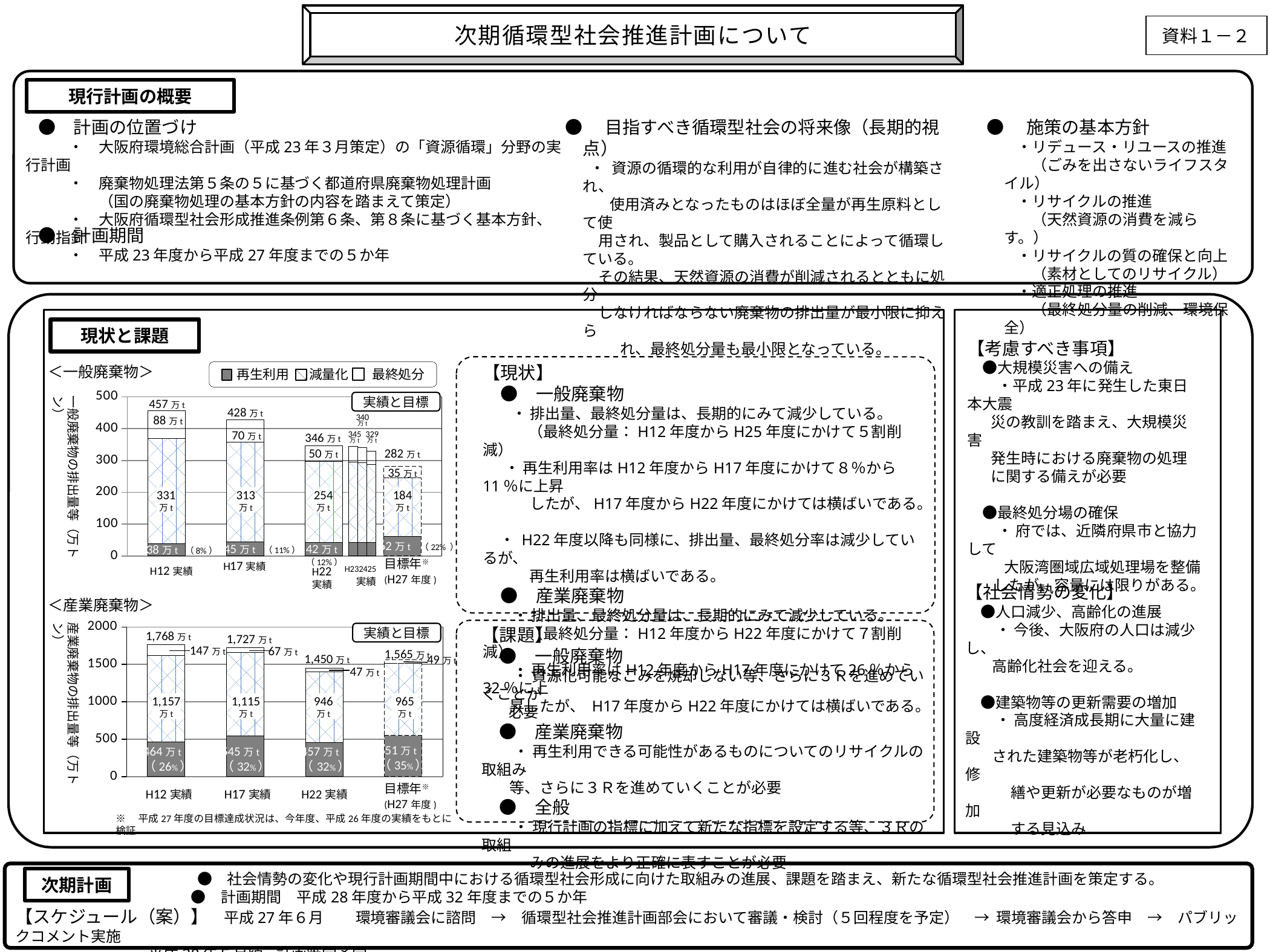
How many series does the legend list for the waste charts? 3 In the 産業廃棄物 chart, what is the total labelled above the H12 実績 bar? 1,768万t In the 一般廃棄物 chart, what is the total labelled above the H12 実績 bar? 457万t In the 一般廃棄物 chart, what percentage is shown next to the 再生利用 segment for H22 実績? 12% In the 一般廃棄物 chart, what is the 最終処分 value for the 目標年 (H27年度) bar? 35万t In the 産業廃棄物 chart, what is the difference between the 最終処分 values for H12 実績 and H17 実績? 80万t What kind of chart is the 産業廃棄物 chart? Stacked bar chart In the 産業廃棄物 chart, what is the 再生利用 value for H17 実績? 545万t In the 産業廃棄物 chart, is the 減量化 value for H12 実績 larger or smaller than the 減量化 value for H22 実績? larger In the 産業廃棄物 chart, which bar has the lowest total? H22 実績 In the 一般廃棄物 chart, what is the difference between the H12 実績 total and the H17 実績 total? 29万t In the 一般廃棄物 chart, what is the 減量化 value for H17 実績? 313万t